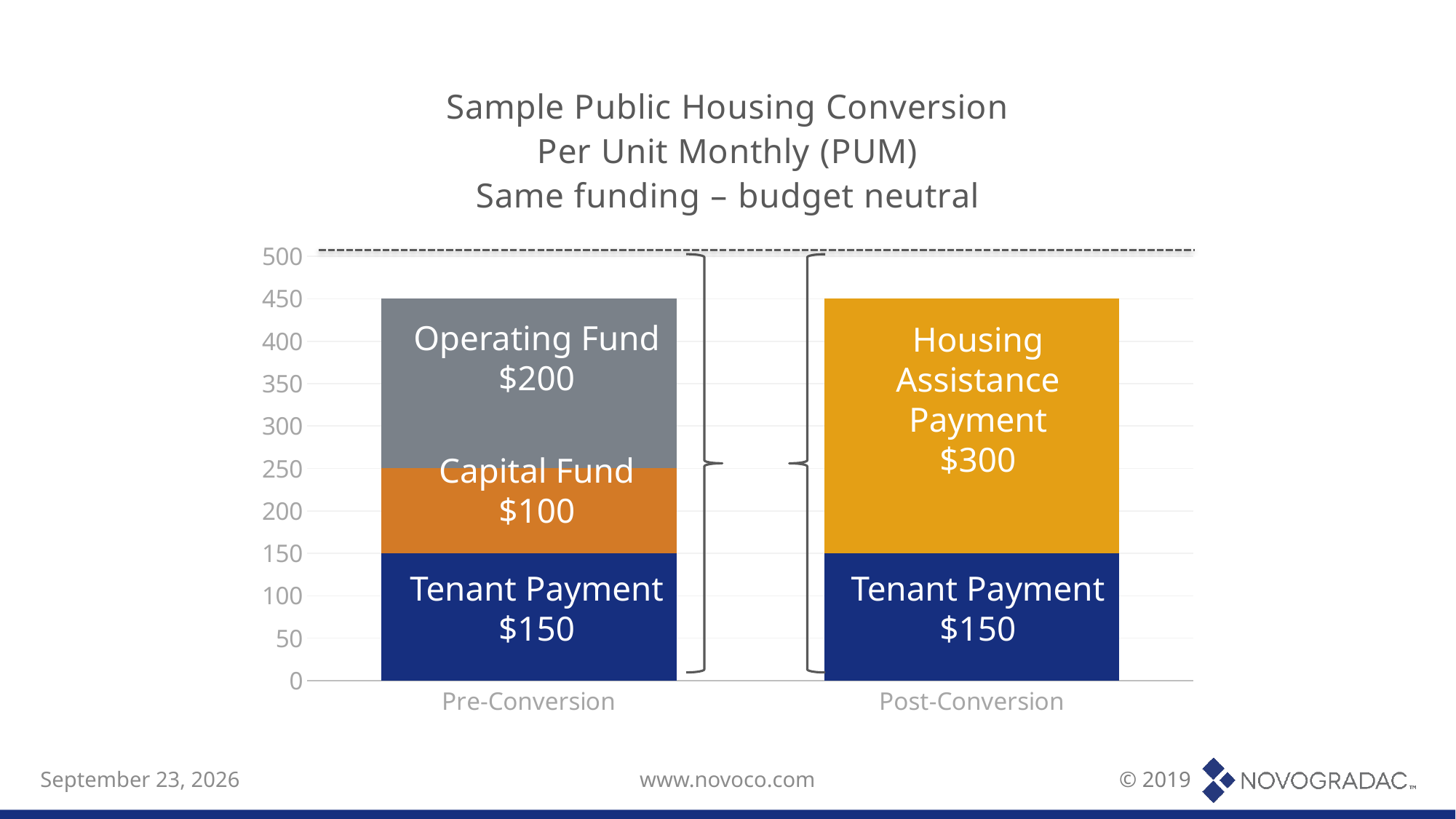
How many categories are shown on the x axis? 2 What is the Housing Assistance Payment value in the Post-Conversion bar? $300 Which is larger, the Operating Fund in Pre-Conversion or the Capital Fund in Pre-Conversion? Operating Fund What is the Operating Fund value in the Pre-Conversion bar? $200 What is the Tenant Payment value in the Post-Conversion bar? $150 What is the Capital Fund value in the Pre-Conversion bar? $100 What is the difference between the Housing Assistance Payment and the Operating Fund? $100 Which segment is the largest in the Pre-Conversion bar? Operating Fund Which segment is the smallest in the Pre-Conversion bar? Capital Fund What is the total of the Pre-Conversion stacked bar? $450 What is the total of the Post-Conversion stacked bar? $450 What kind of chart is shown on the slide? Stacked bar chart